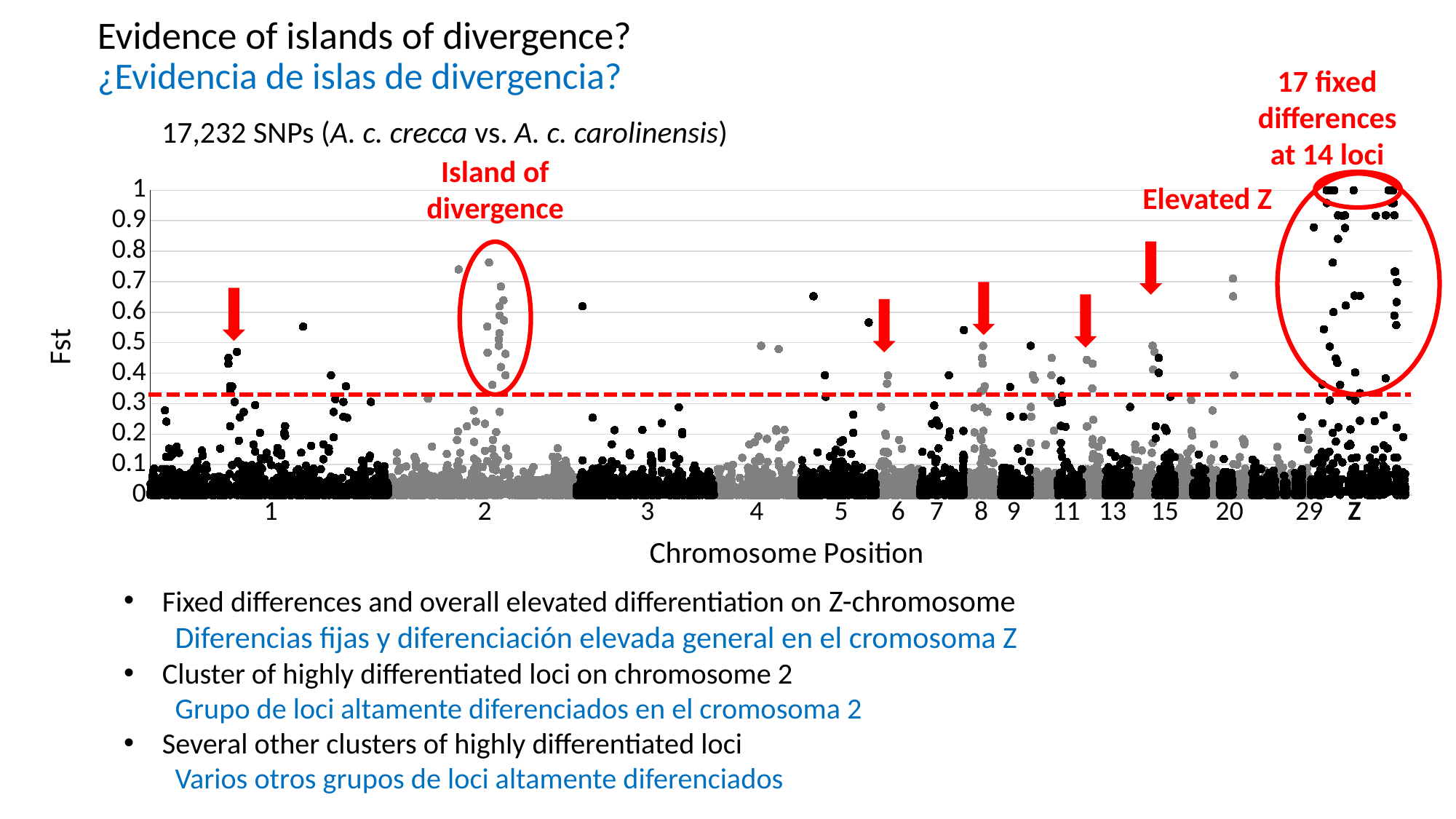
Is the highest Fst value on chromosome 2 greater or less than 0.7? greater Is the highest Fst value on chromosome 3 greater or less than 0.5? greater How many chromosome labels are shown along the x axis of the chart? 15 What is the label of the y axis of the chart? Fst Is the highest Fst value on chromosome 4 greater or less than 0.6? less Which chromosome has the points with the highest Fst values in the chart? Z What kind of chart is shown on the slide? Scatter plot What is the highest Fst value reached by points on the Z chromosome? 1 What is the highest tick value shown on the y axis of the chart? 1 Which chromosome has higher maximum Fst values, chromosome 2 or chromosome 4? Chromosome 2 What is the label of the x axis of the chart? Chromosome Position How many SNPs does the chart heading say were analysed? 17,232 SNPs